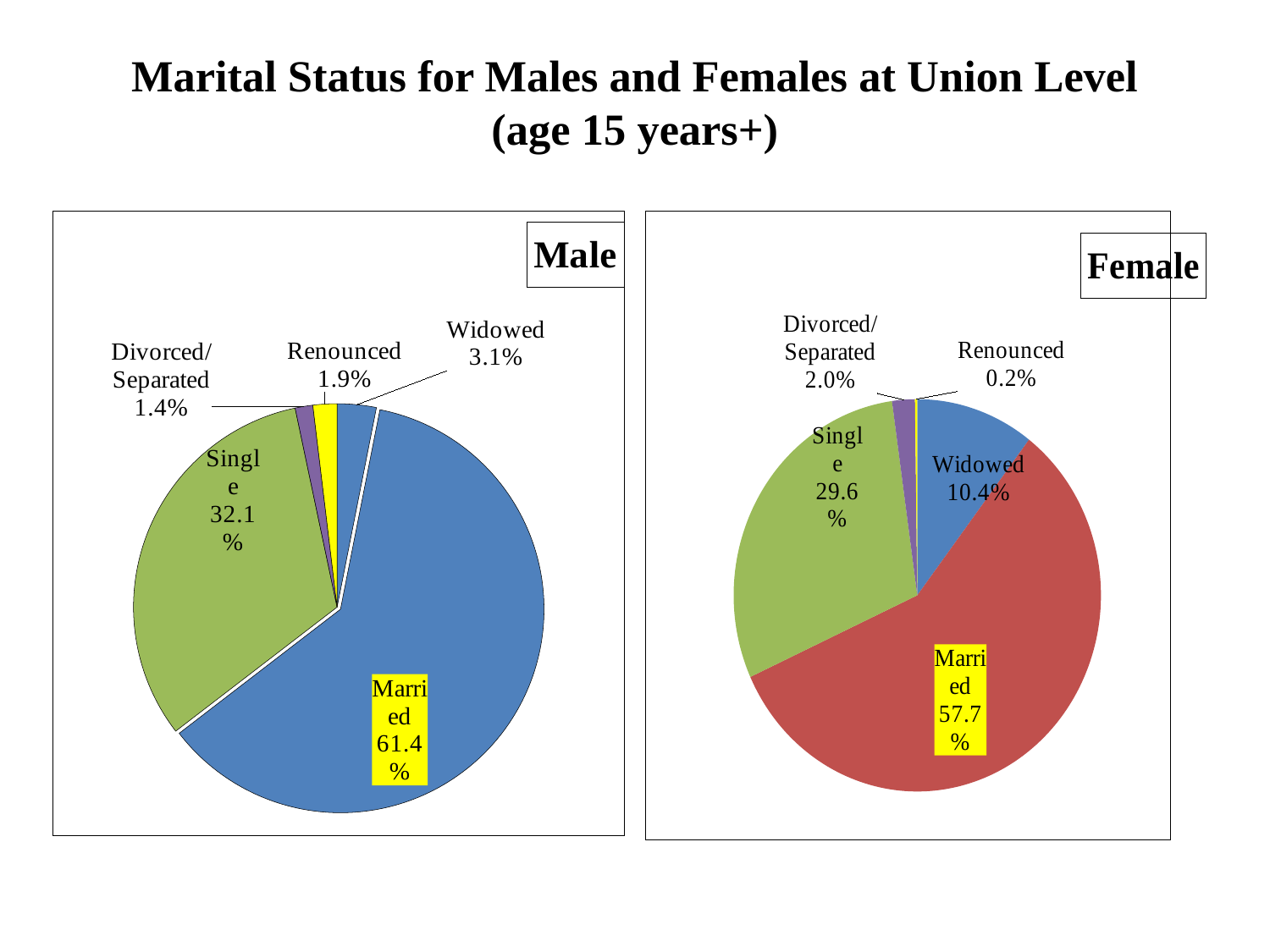
What is the difference between the Married share in the Male chart and the Married share in the Female chart? 3.7% What type of chart is used for the Male data? Pie chart In the Male pie chart, which category has the largest share? Married In the Male pie chart, which category has the smallest share? Divorced/Separated Is the Widowed share larger in the Male chart or the Female chart? Female In the Female pie chart, which category has the smallest share? Renounced In the Male pie chart, what percentage is Married? 61.4% In the Female pie chart, what percentage is Single? 29.6% In the Male pie chart, what percentage is Renounced? 1.9% In the Female pie chart, what percentage is Widowed? 10.4% How many categories are shown in the Female pie chart? 5 What is the title of the slide? Marital Status for Males and Females at Union Level (age 15 years+)